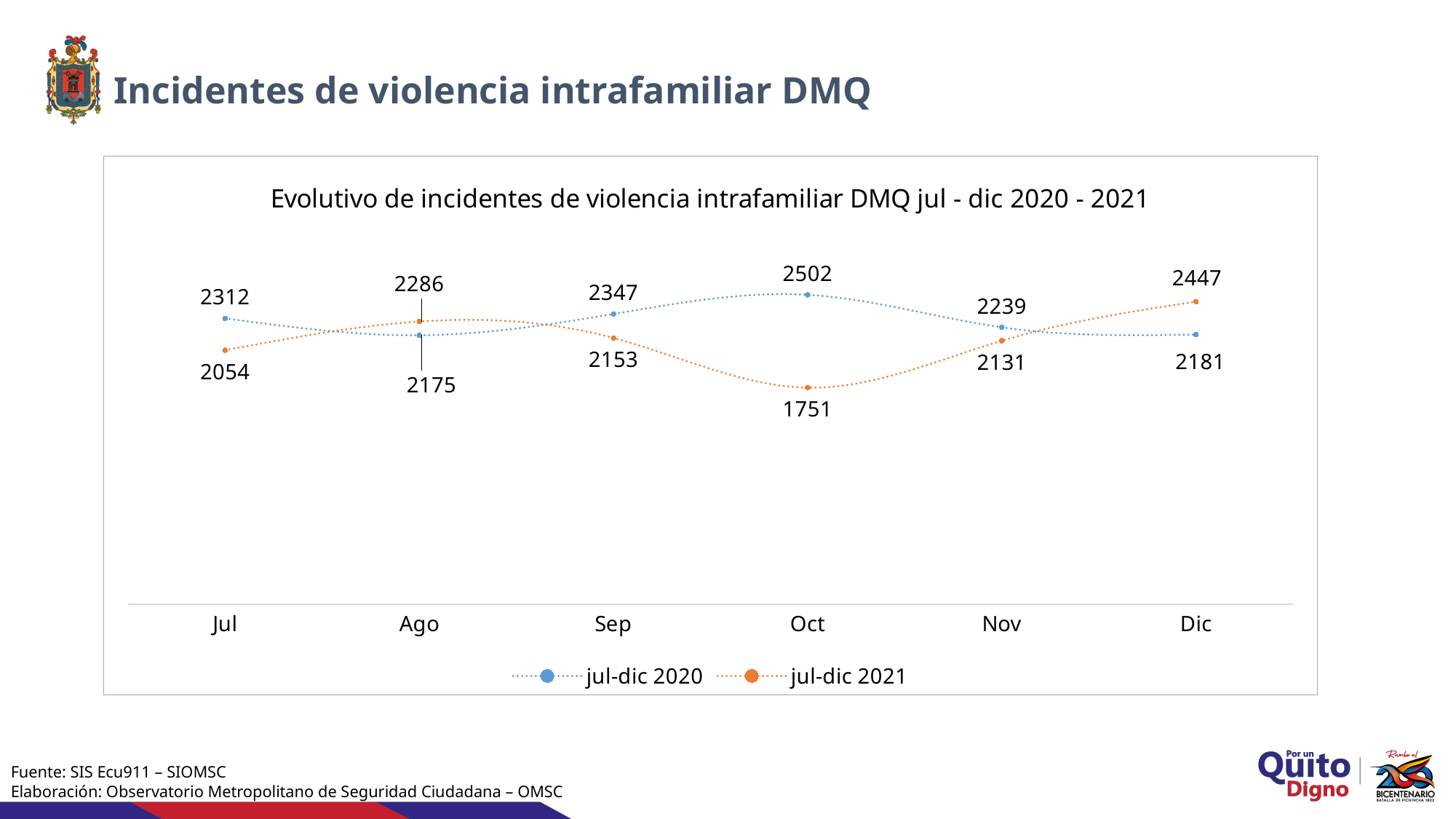
What is the value for jul-dic 2021 in Dic? 2447 In which month is the jul-dic 2021 series highest? Dic How many series does the legend list? 2 What is the difference between jul-dic 2021 and jul-dic 2020 in Dic? 266 What is the value for jul-dic 2021 in Ago? 2286 What kind of chart is shown on the slide? Line chart How many months are shown on the x axis? 6 What is the difference between jul-dic 2020 and jul-dic 2021 in Oct? 751 Which series has the larger value in Jul, jul-dic 2020 or jul-dic 2021? jul-dic 2020 In which month is the jul-dic 2020 series highest? Oct What is the value for jul-dic 2020 in Oct? 2502 In which month is the jul-dic 2021 series lowest? Oct